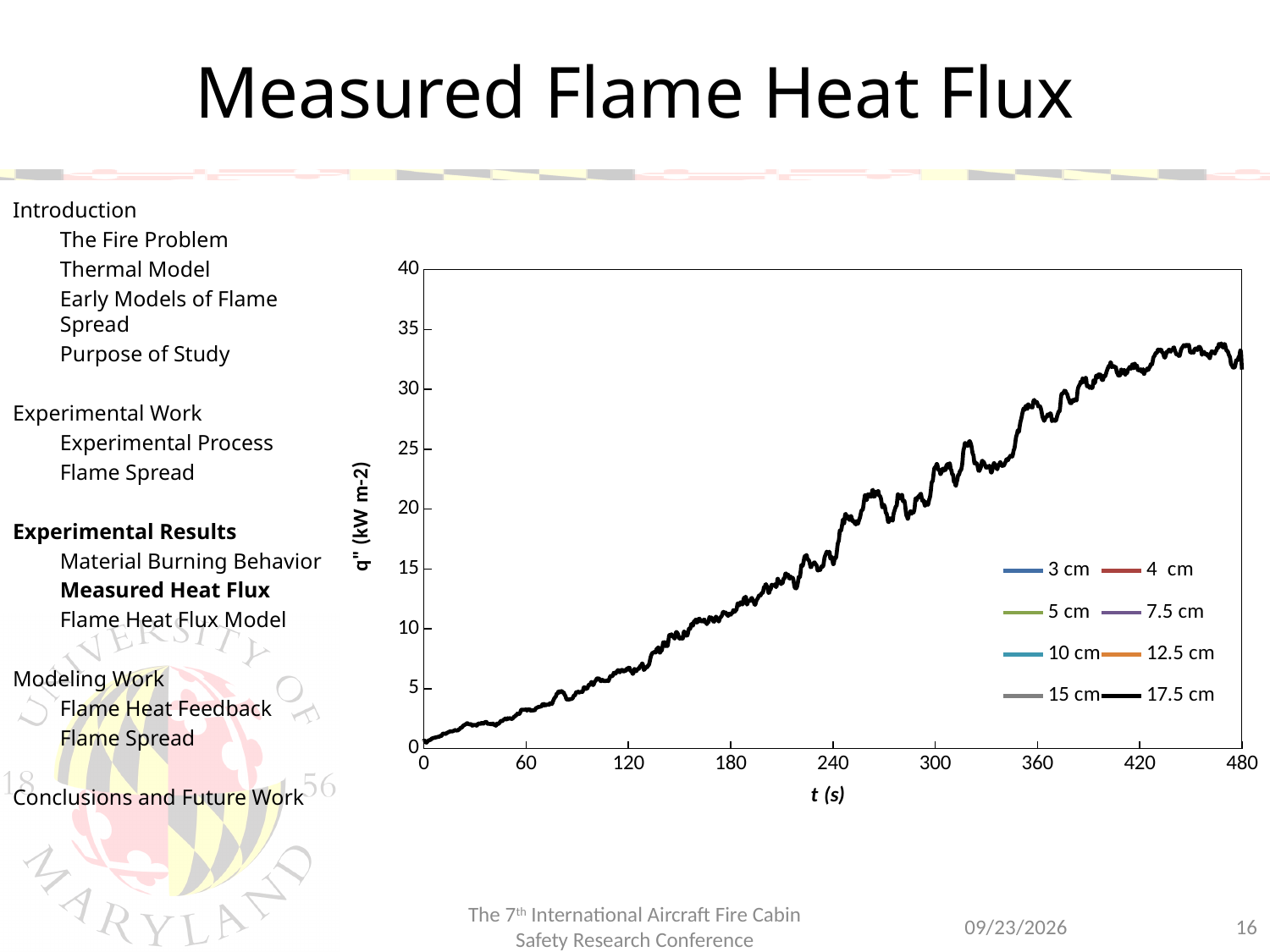
What is the label of the chart's x axis? t (s) Does the plotted heat flux rise or fall as t increases from 0 to 480 s? rise Is the value of the plotted curve at t = 60 s greater or less than 5? less Is the value of the plotted curve at t = 480 s greater or less than 30? greater Is the value of the plotted curve at t = 360 s greater or less than 25? greater How many series does the chart's legend list? 8 What kind of chart is shown on the slide? line chart Which legend series is drawn in black on the chart? 17.5 cm